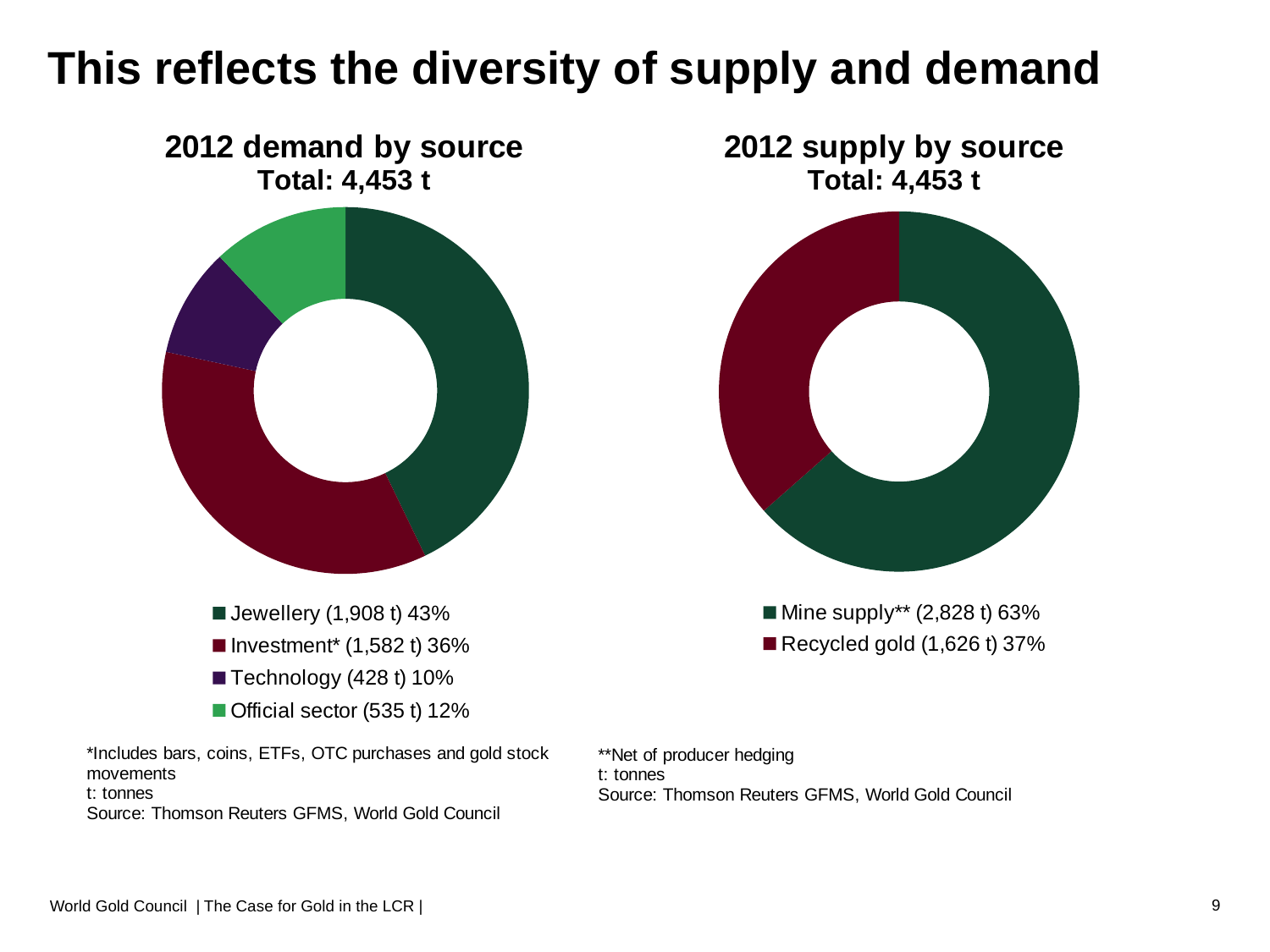
In the '2012 supply by source' chart, what percentage share does Recycled gold have? 37% What total is stated in the title of the '2012 demand by source' chart? 4,453 t In the '2012 demand by source' chart, how many categories are shown? 4 In the '2012 demand by source' chart, which category is the smallest? Technology In the '2012 demand by source' chart, what percentage share does Investment* have? 36% In the '2012 supply by source' chart, how many tonnes does Mine supply** account for? 2,828 t In the '2012 demand by source' chart, which category is the largest? Jewellery What kind of chart is the '2012 supply by source' chart? Doughnut (pie) chart In the '2012 demand by source' chart, what is the difference in tonnes between Jewellery and Investment*? 326 t In the '2012 demand by source' chart, how many tonnes does Jewellery account for? 1,908 t In the '2012 supply by source' chart, which is larger, Mine supply** or Recycled gold? Mine supply** In the '2012 supply by source' chart, what is the difference in tonnes between Mine supply** and Recycled gold? 1,202 t